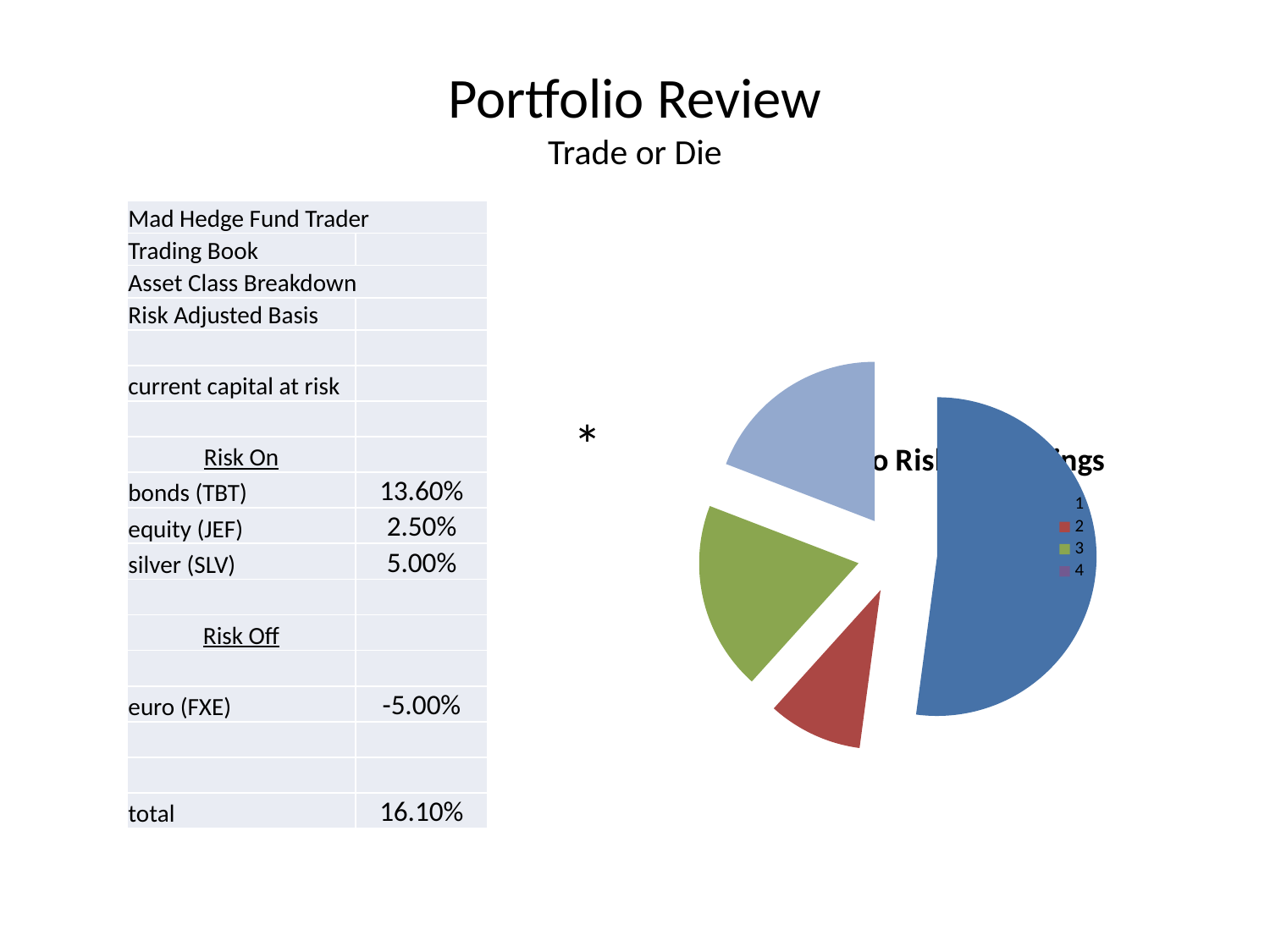
In the pie chart, which slice is larger, the one for legend entry 1 or the one for legend entry 2? 1 What colour is the slice for legend entry 1 in the pie chart? blue How many entries does the pie chart's legend list? 4 How many slices does the pie chart have? 4 In the pie chart, which slice is larger, the one for legend entry 3 or the one for legend entry 2? 3 Which legend entry corresponds to the smallest slice of the pie chart? 2 Which legend entry corresponds to the largest slice of the pie chart? 1 What kind of chart is shown on the right side of the slide? pie chart What colour is the slice for legend entry 3 in the pie chart? green